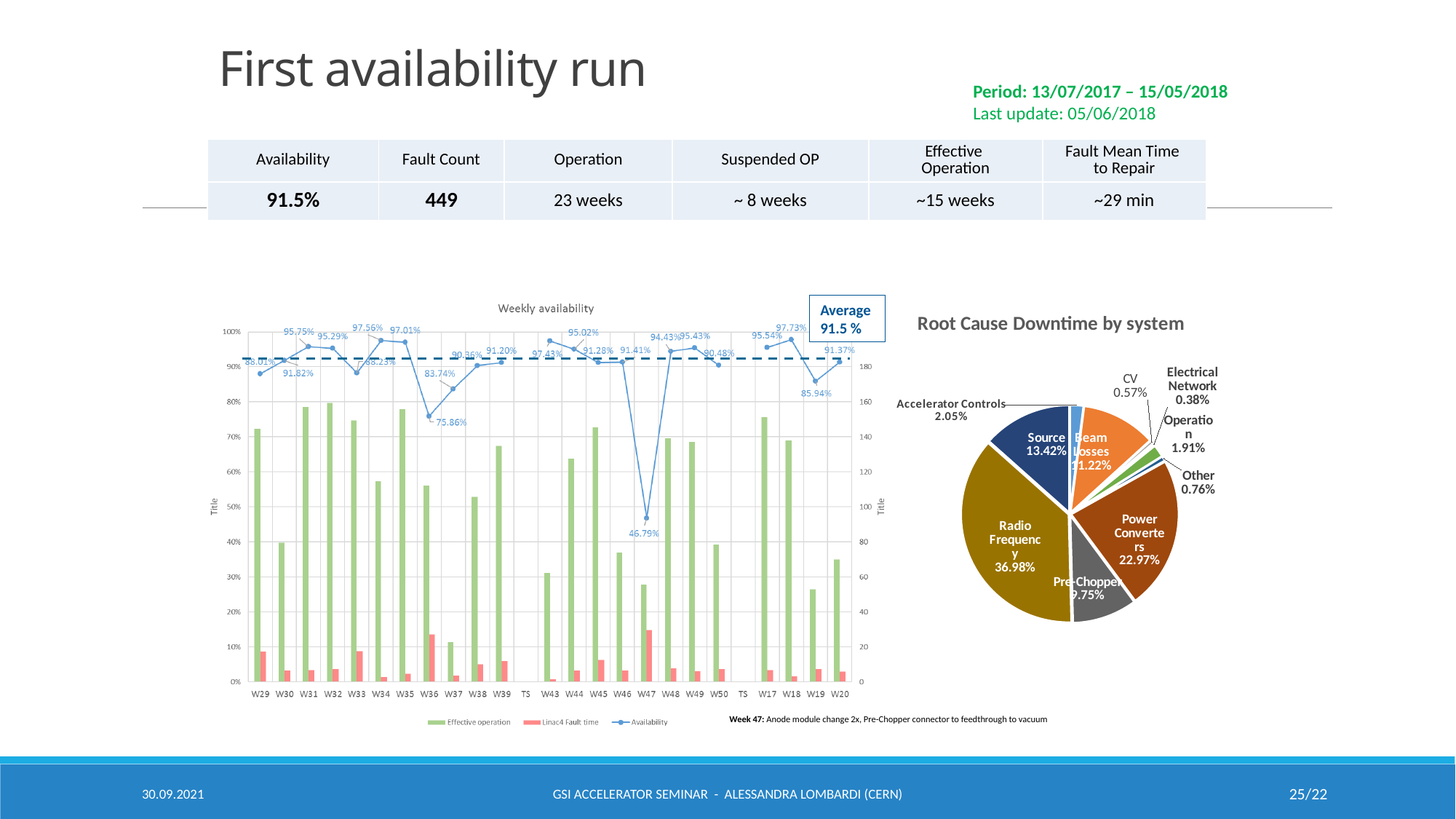
In the Weekly availability chart, is the availability higher for W31 or W32? W31 In the Root Cause Downtime by system chart, which system has the largest share? Radio Frequency In the Root Cause Downtime by system chart, what share do Power Converters have? 22.97% In the Weekly availability chart, is the Effective operation value for W36 greater or less than 50%? greater How many slices does the Root Cause Downtime by system chart have? 10 In the Weekly availability chart, what is the availability for W36? 75.86% In the Weekly availability chart, what is the availability value for W47? 46.79% In the Root Cause Downtime by system chart, which system has the smallest share? Electrical Network In the Weekly availability chart, what is the difference between the availability of W18 and W47? 50.94 percentage points In the Weekly availability chart, which week has the highest availability? W18 In the Weekly availability chart, which week has the lowest availability? W47 How many series does the legend of the Weekly availability chart list? 3